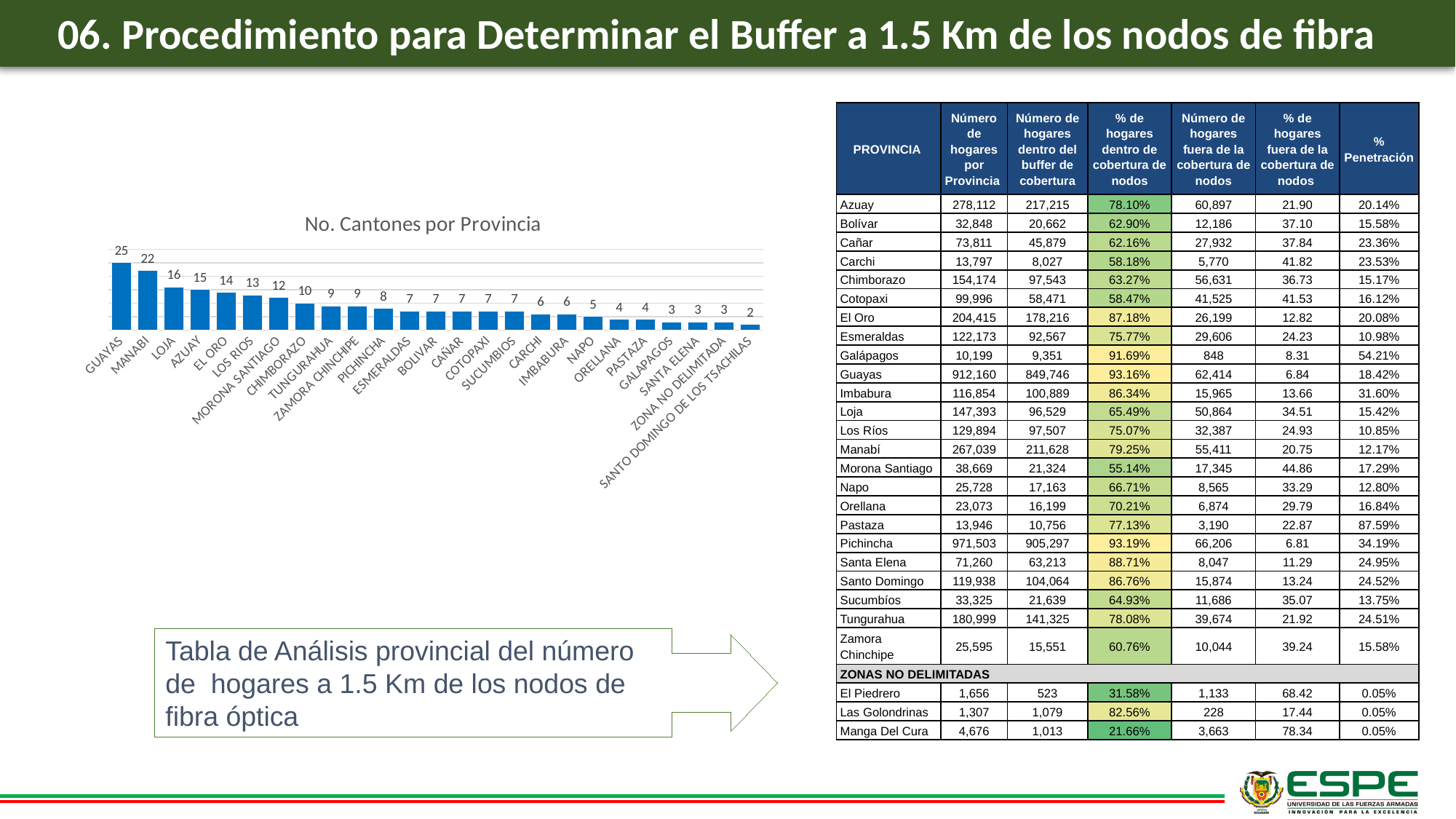
Do the values in the chart 'No. Cantones por Provincia' rise or fall from left to right? fall In the chart 'No. Cantones por Provincia', what is the value for PICHINCHA? 8 Which province has the highest number of cantones in the chart? GUAYAS In the chart, which has a larger value, LOJA or EL ORO? LOJA What is the difference between the values for GUAYAS and MANABI in the chart? 3 In the chart 'No. Cantones por Provincia', what is the value for MORONA SANTIAGO? 12 In the chart, what is the value for NAPO? 5 In the chart 'No. Cantones por Provincia', what is the value for GUAYAS? 25 Which province has the lowest number of cantones in the chart? SANTO DOMINGO DE LOS TSACHILAS How many provinces (categories) are shown in the chart 'No. Cantones por Provincia'? 25 What kind of chart is shown on the slide? bar chart What is the title of the chart on the slide? No. Cantones por Provincia